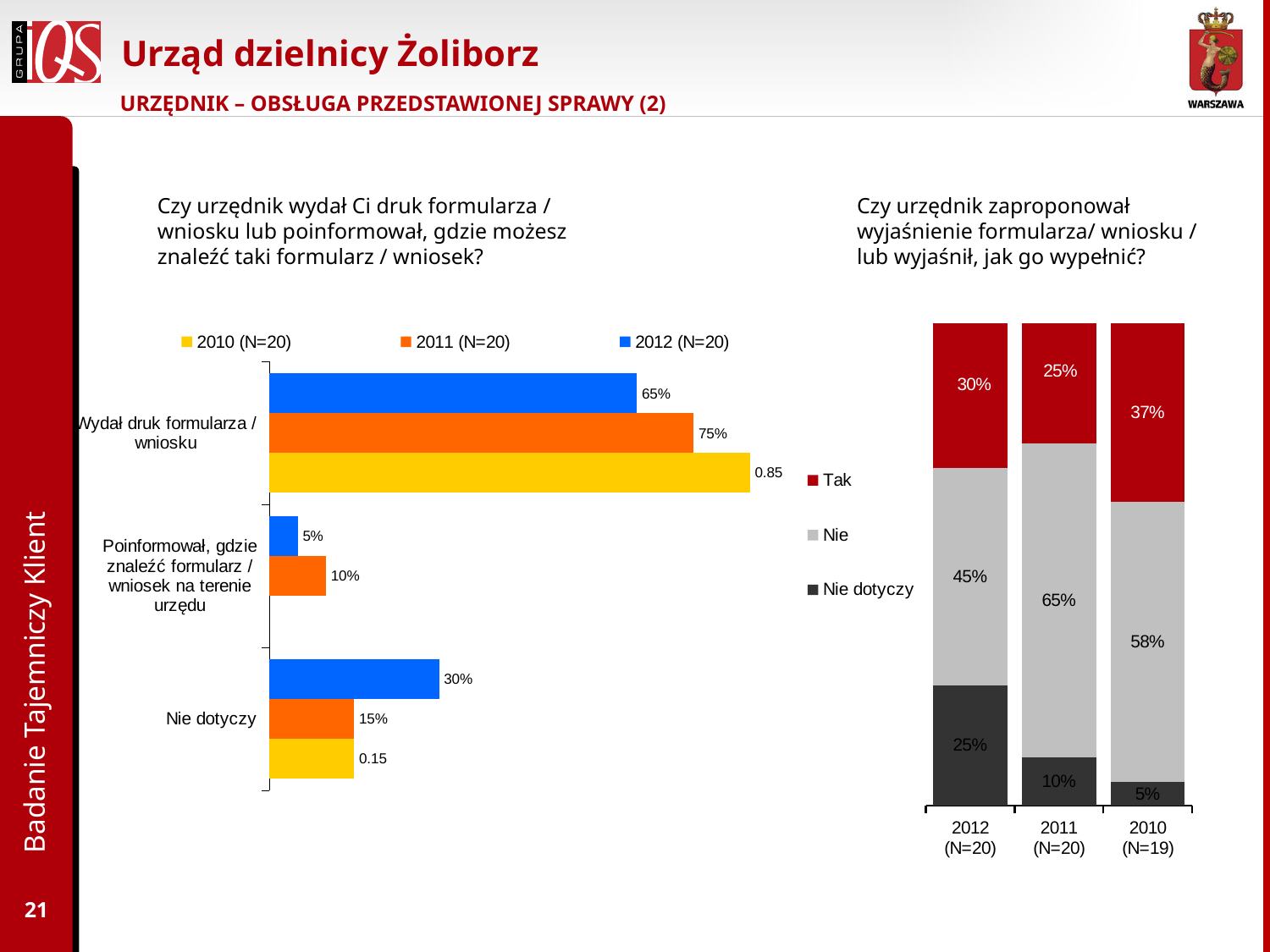
In the left chart, which is larger for 'Poinformował, gdzie znaleźć formularz / wniosek na terenie urzędu': the 2011 value or the 2012 value? 2011 (N=20) In the left chart, what is the 2012 (N=20) value for 'Nie dotyczy'? 30% In the left chart, what is the 2011 (N=20) value for 'Wydał druk formularza / wniosku'? 75% In the left chart, what is the 2010 (N=20) value for 'Wydał druk formularza / wniosku'? 0.85 What kind of chart is the left chart? Bar chart In the right chart, what is the total of the 2012 (N=20) stacked bar? 100% How many series does the legend of the left chart list? 3 In the left chart, which year has the highest value for 'Wydał druk formularza / wniosku'? 2010 (N=20) In the right chart, which year has the lowest 'Nie dotyczy' share? 2010 (N=19) In the right chart, what is the 'Nie' share for 2011 (N=20)? 65% In the left chart, what is the difference between the 2011 and 2012 values for 'Wydał druk formularza / wniosku'? 10% In the right chart, what is the 'Tak' share for 2010 (N=19)? 37%